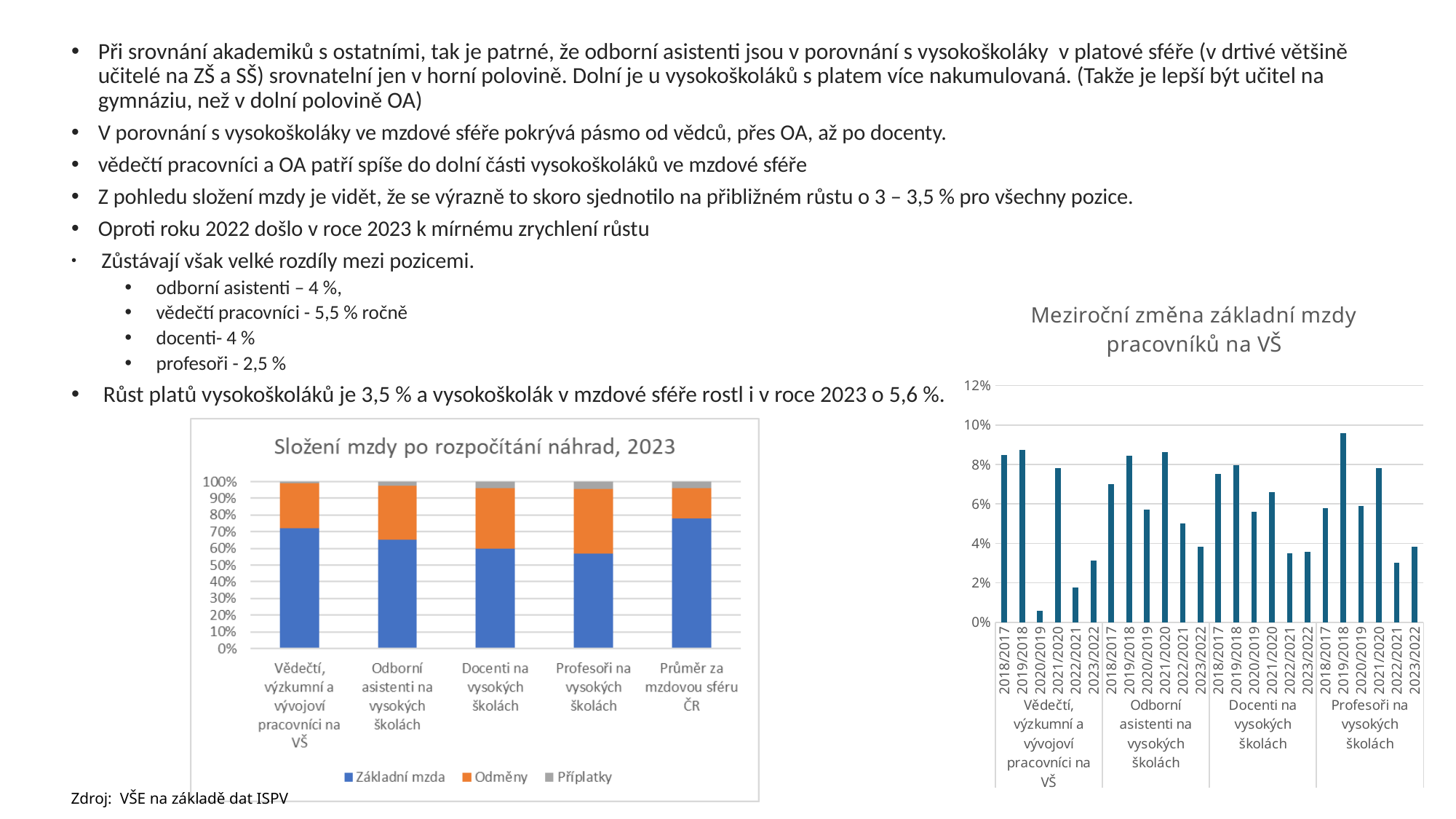
In the left chart 'Složení mzdy po rozpočítání náhrad, 2023', which category has the largest share of Základní mzda? Průměr za mzdovou sféru ČR In the left chart 'Složení mzdy po rozpočítání náhrad, 2023', is the Základní mzda share for Profesoři na vysokých školách greater or less than 60%? less In the right chart 'Meziroční změna základní mzdy pracovníků na VŠ', which bar is the highest? Profesoři na vysokých školách, 2019/2018 In the left chart 'Složení mzdy po rozpočítání náhrad, 2023', what colour represents Odměny in the legend? orange What type of chart is the left chart titled 'Složení mzdy po rozpočítání náhrad, 2023'? stacked bar chart In the left chart 'Složení mzdy po rozpočítání náhrad, 2023', which category has the smallest share of Základní mzda? Profesoři na vysokých školách What is the title of the right chart? Meziroční změna základní mzdy pracovníků na VŠ How many categories are shown on the x axis of the left chart 'Složení mzdy po rozpočítání náhrad, 2023'? 5 In the right chart 'Meziroční změna základní mzdy pracovníků na VŠ', is the value for Docenti na vysokých školách in 2022/2021 greater or less than 4%? less How many series does the legend of the left chart 'Složení mzdy po rozpočítání náhrad, 2023' list? 3 In the left chart 'Složení mzdy po rozpočítání náhrad, 2023', is the Základní mzda share for Průměr za mzdovou sféru ČR greater or less than 70%? greater In the right chart 'Meziroční změna základní mzdy pracovníků na VŠ', which bar is the lowest? Vědečtí, výzkumní a vývojoví pracovníci na VŠ, 2020/2019